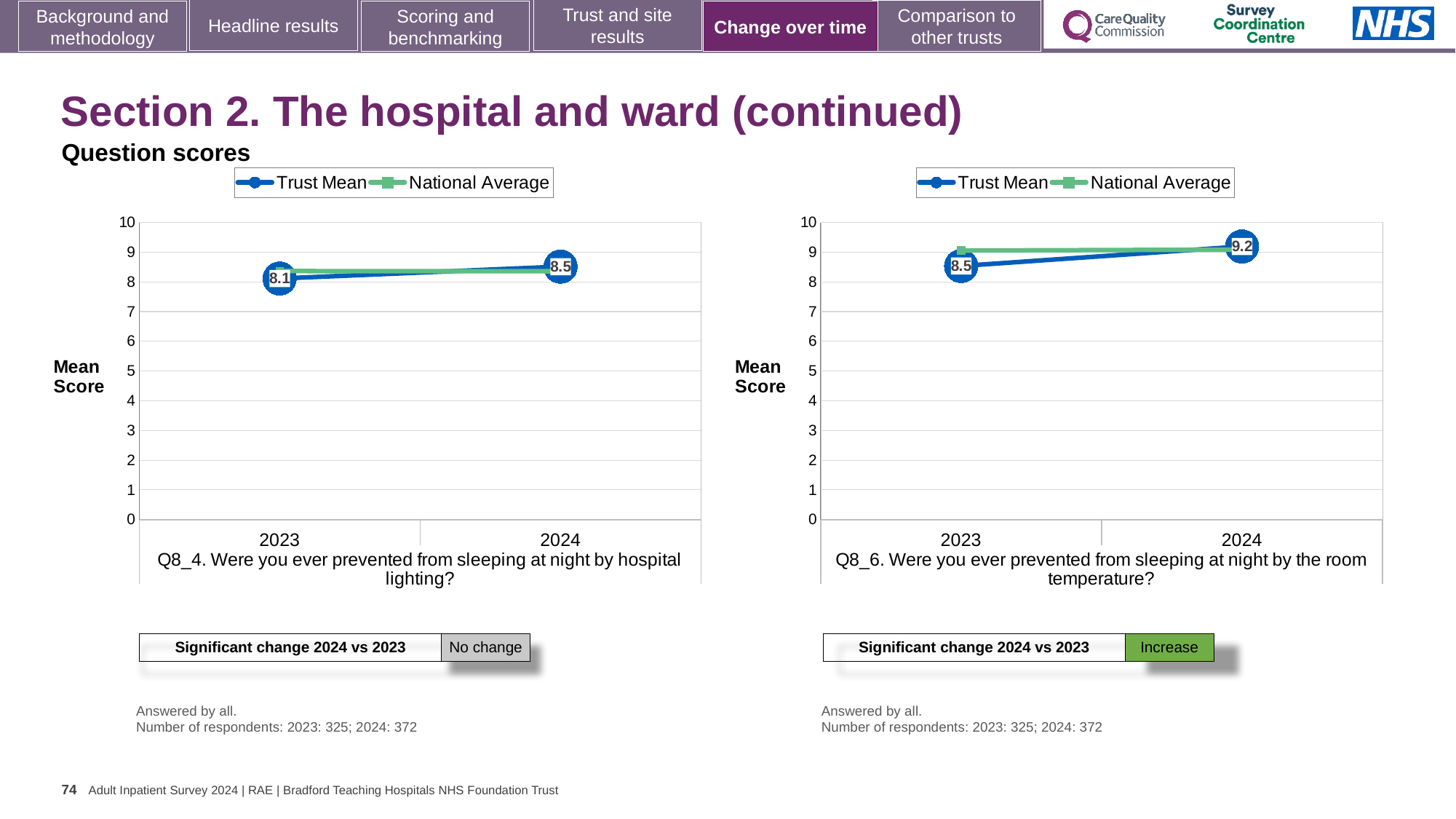
In the Q8_6 chart (right), what is the Trust Mean score for 2023? 8.5 In the Q8_4 chart (left), what is the Trust Mean score for 2023? 8.1 In the Q8_4 chart (left), what is the Trust Mean score for 2024? 8.5 In the Q8_6 chart (right), what is the Trust Mean score for 2024? 9.2 What does the 'Significant change 2024 vs 2023' box below the Q8_6 chart (right) say? Increase In the Q8_6 chart (right), is the National Average for 2023 greater or less than 8? greater How many years are shown on the x axis of the Q8_4 chart (left)? 2 In the Q8_6 chart (right), by how much did the Trust Mean change from 2023 to 2024? 0.7 In the Q8_6 chart (right), does the Trust Mean rise or fall from 2023 to 2024? rise In the Q8_4 chart (left), by how much did the Trust Mean change from 2023 to 2024? 0.4 What kind of chart is the Q8_4 chart (left)? line chart How many series does the legend of the Q8_6 chart (right) list? 2